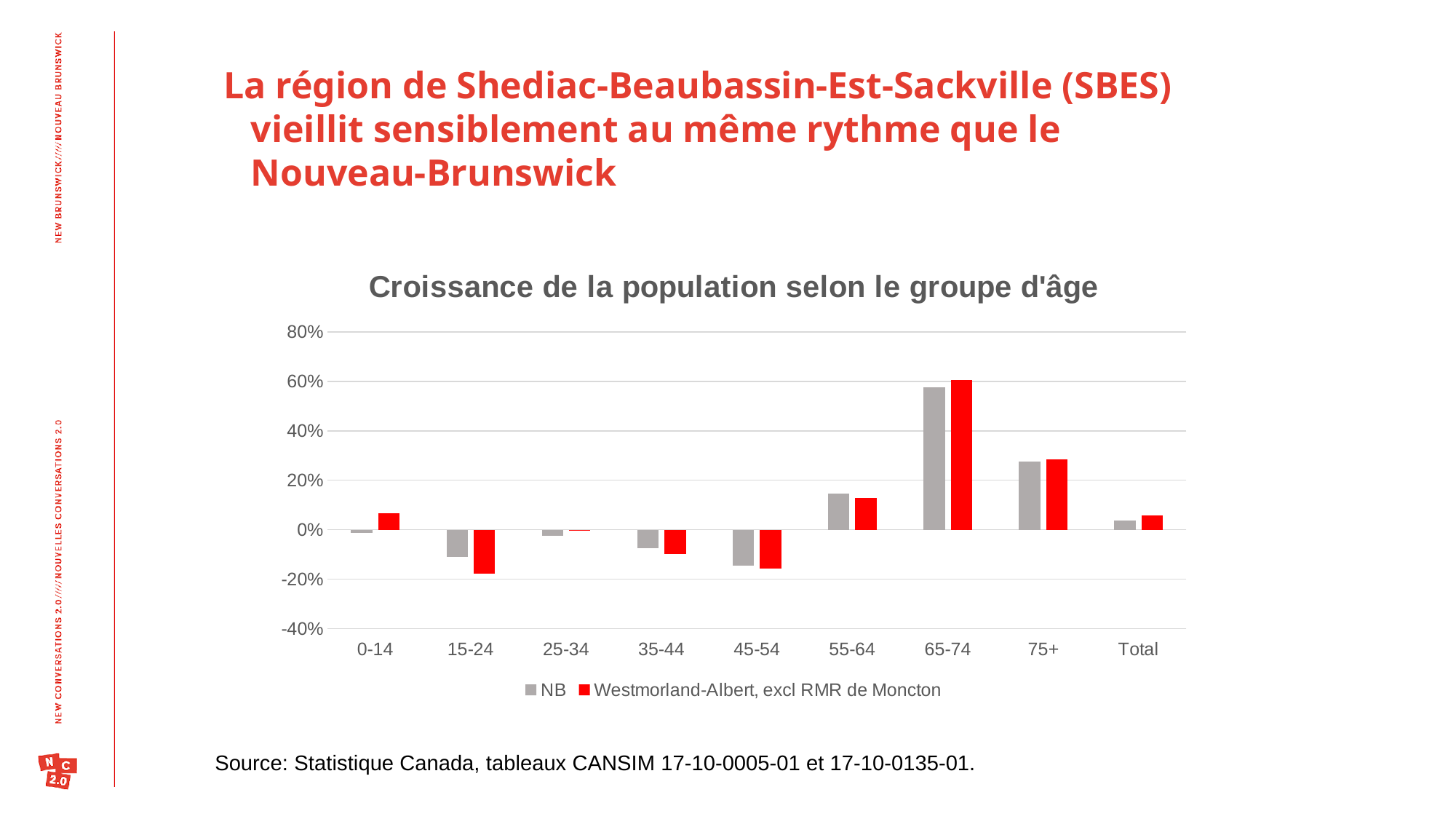
How many series does the legend list? 2 Which category has the highest value for the NB series? 65-74 For the 0-14 age group, which series has the larger value, NB or Westmorland-Albert, excl RMR de Moncton? Westmorland-Albert, excl RMR de Moncton Is the NB value for 65-74 greater or less than 40%? greater For the 15-24 age group, which series has the larger value, NB or Westmorland-Albert, excl RMR de Moncton? NB What is the title of the chart? Croissance de la population selon le groupe d'âge Which category has the lowest value for the NB series? 45-54 Is the NB value for 75+ greater or less than 20%? greater Is the Westmorland-Albert, excl RMR de Moncton value for 15-24 greater or less than 0%? less Which category has the highest value for the Westmorland-Albert, excl RMR de Moncton series? 65-74 What kind of chart is shown on the slide? Bar chart How many age-group categories (including Total) are shown on the x axis? 9